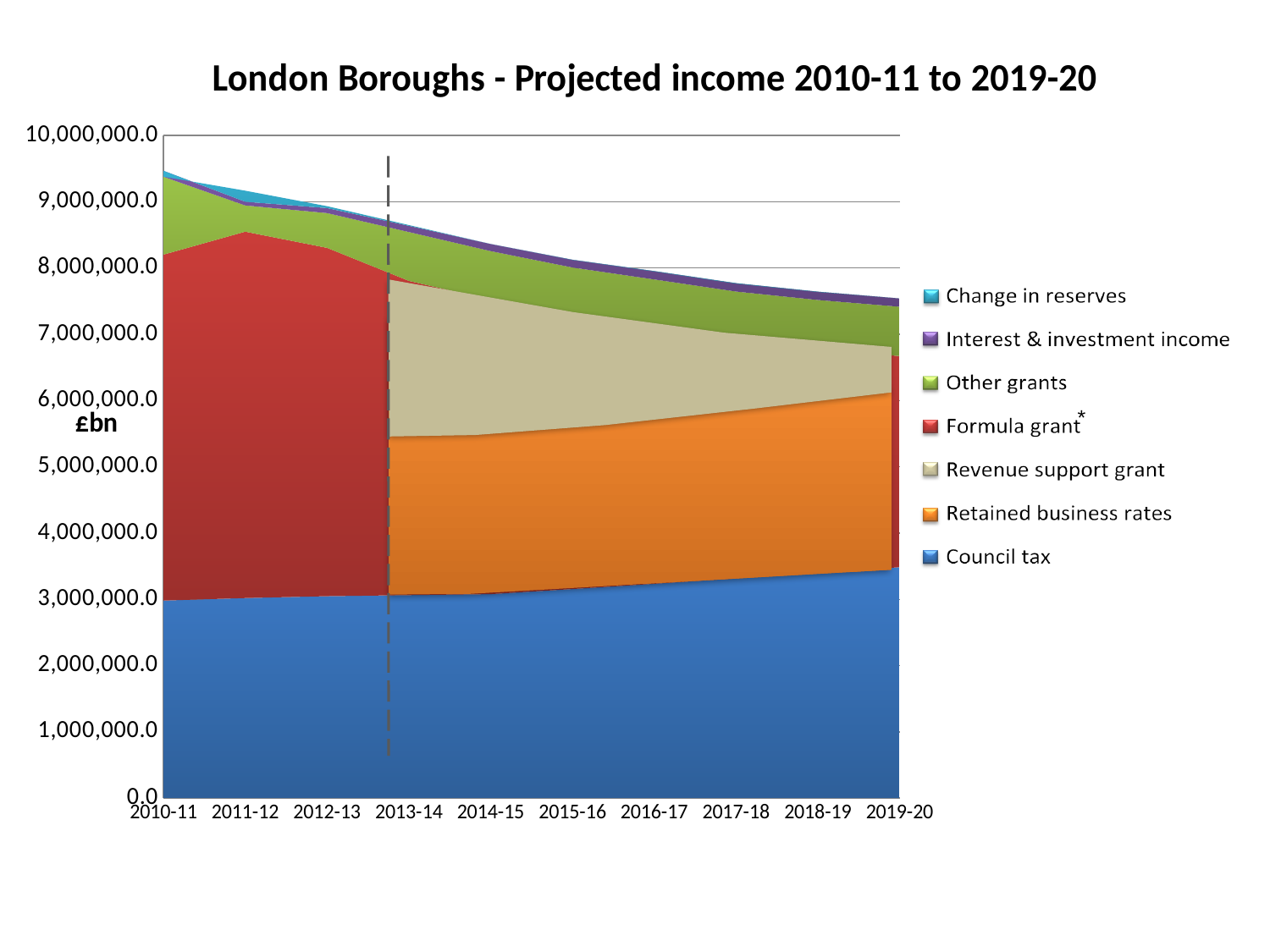
Does the total projected income rise or fall from 2010-11 to 2019-20? Fall What kind of chart is shown on the slide? Stacked area chart How many years are shown along the x axis? 10 Which year has the lowest total projected income? 2019-20 Is the total projected income for 2010-11 greater or less than 9,000,000.0? greater Which series is at the bottom of the stacked areas? Council tax What is the title of the chart? London Boroughs - Projected income 2010-11 to 2019-20 Is the total projected income for 2019-20 greater or less than 8,000,000.0? less Which is larger, the total projected income in 2010-11 or in 2019-20? 2010-11 Which year has the highest total projected income? 2010-11 Is the value for Council tax in 2019-20 greater or less than 3,000,000.0? greater How many series does the legend list? 7